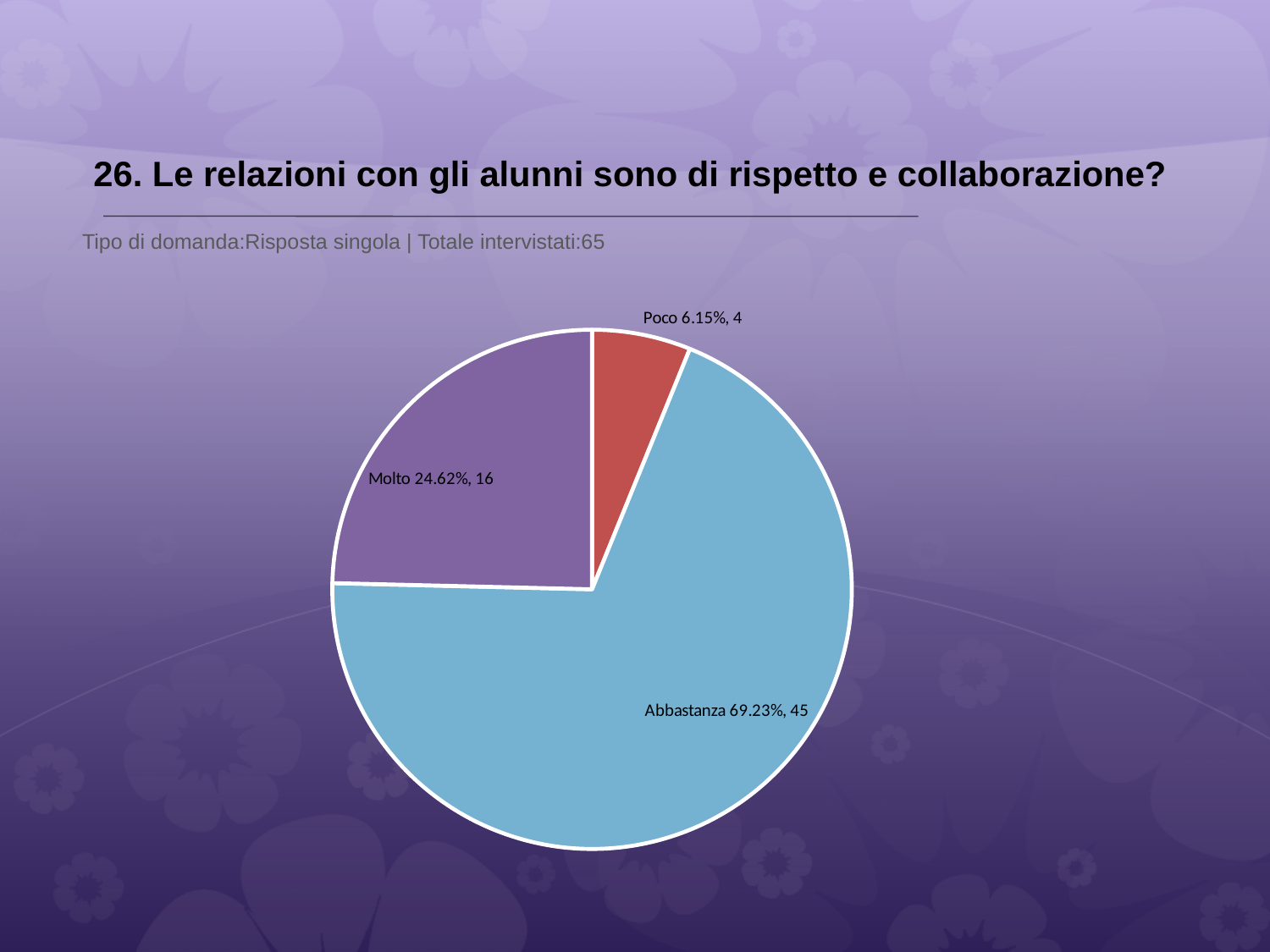
Which category has the smallest slice? Poco What percentage share does the Poco slice have? 6.15% How many respondents answered Abbastanza? 45 How many slices does the pie chart have? 3 What kind of chart is shown on the slide? pie chart What percentage share does the Abbastanza slice have? 69.23% Which slice is larger, Molto or Poco? Molto What is the difference in respondent count between Abbastanza and Molto? 29 What percentage share does the Molto slice have? 24.62% How many respondents answered Poco? 4 Which category has the largest slice? Abbastanza How many respondents answered Molto? 16